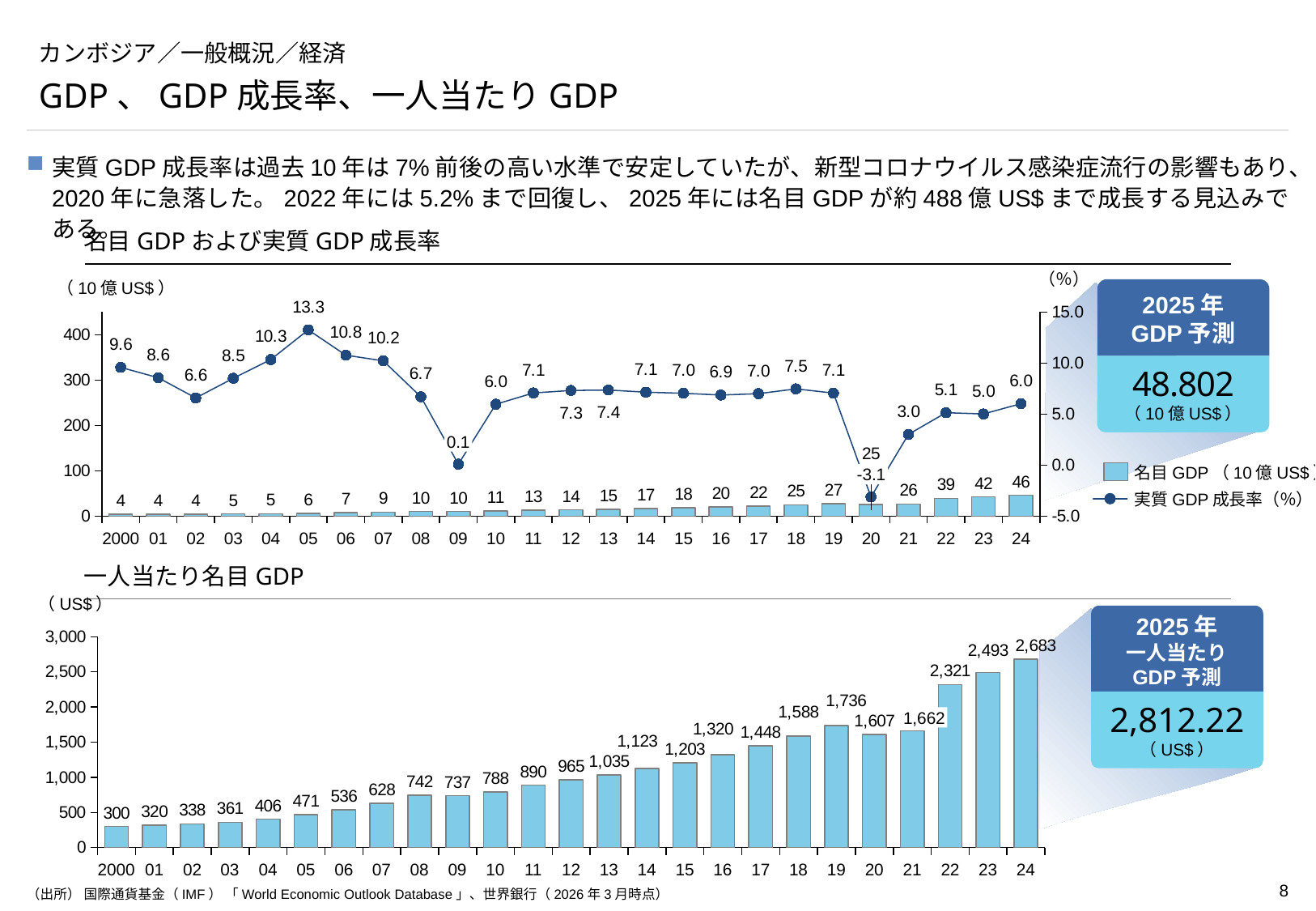
In the top chart (名目GDPおよび実質GDP成長率), what is the 名目GDP value for 2024? 46 In the bottom chart (一人当たり名目GDP), what is the value for 2019? 1,736 In the bottom chart (一人当たり名目GDP), which year has the lowest value? 2000 In the top chart (名目GDPおよび実質GDP成長率), what is the 実質GDP成長率 for 2005? 13.3 What kind of chart is the bottom chart (一人当たり名目GDP)? Bar chart In the bottom chart (一人当たり名目GDP), what is the difference between the 2024 value and the 2023 value? 190 In the top chart (名目GDPおよび実質GDP成長率), what is the 実質GDP成長率 for 2020? -3.1 In the top chart (名目GDPおよび実質GDP成長率), which year has the lowest 実質GDP成長率? 2020 In the top chart (名目GDPおよび実質GDP成長率), what is the difference in 名目GDP between 2023 and 2022? 3 In the top chart (名目GDPおよび実質GDP成長率), how many series does the legend list? 2 In the bottom chart (一人当たり名目GDP), which year has the highest value? 2024 In the bottom chart (一人当たり名目GDP), which is larger, the value for 2019 or the value for 2020? 2019